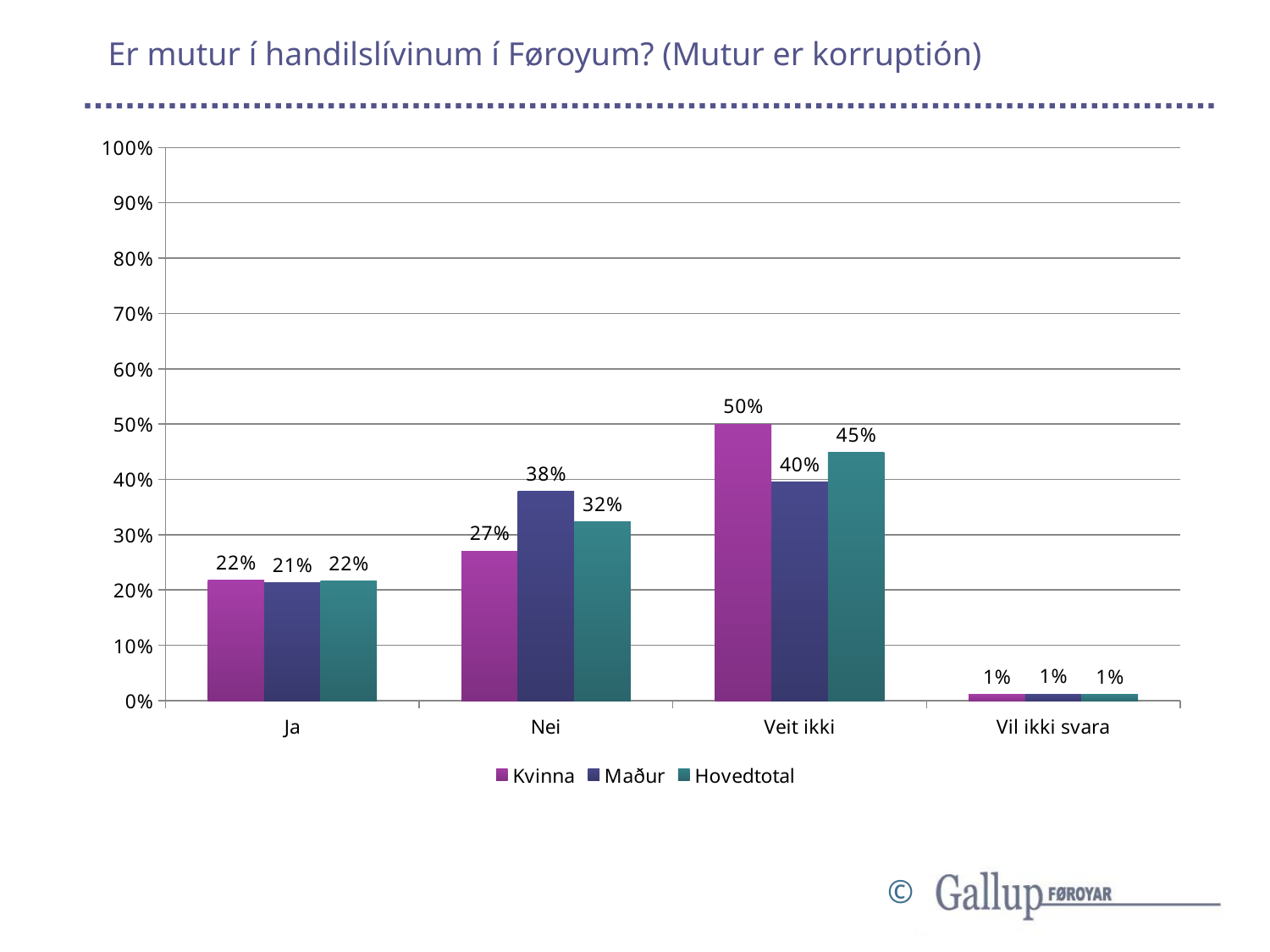
What is the value for Kvinna in the Veit ikki category? 50% How many categories are shown on the x axis? 4 What is the Hovedtotal value for Ja? 22% What is the value for Maður in the Nei category? 38% Which category has the highest Hovedtotal value? Veit ikki Is the Hovedtotal value for Nei greater or less than 30%? greater Which is larger for Nei: the Kvinna value or the Maður value? Maður What are the three series listed in the legend? Kvinna, Maður, Hovedtotal How many series does the legend list? 3 What kind of chart is shown on the slide? bar chart What is the difference between the Kvinna and Maður values for Veit ikki? 10% Which category has the lowest Kvinna value? Vil ikki svara